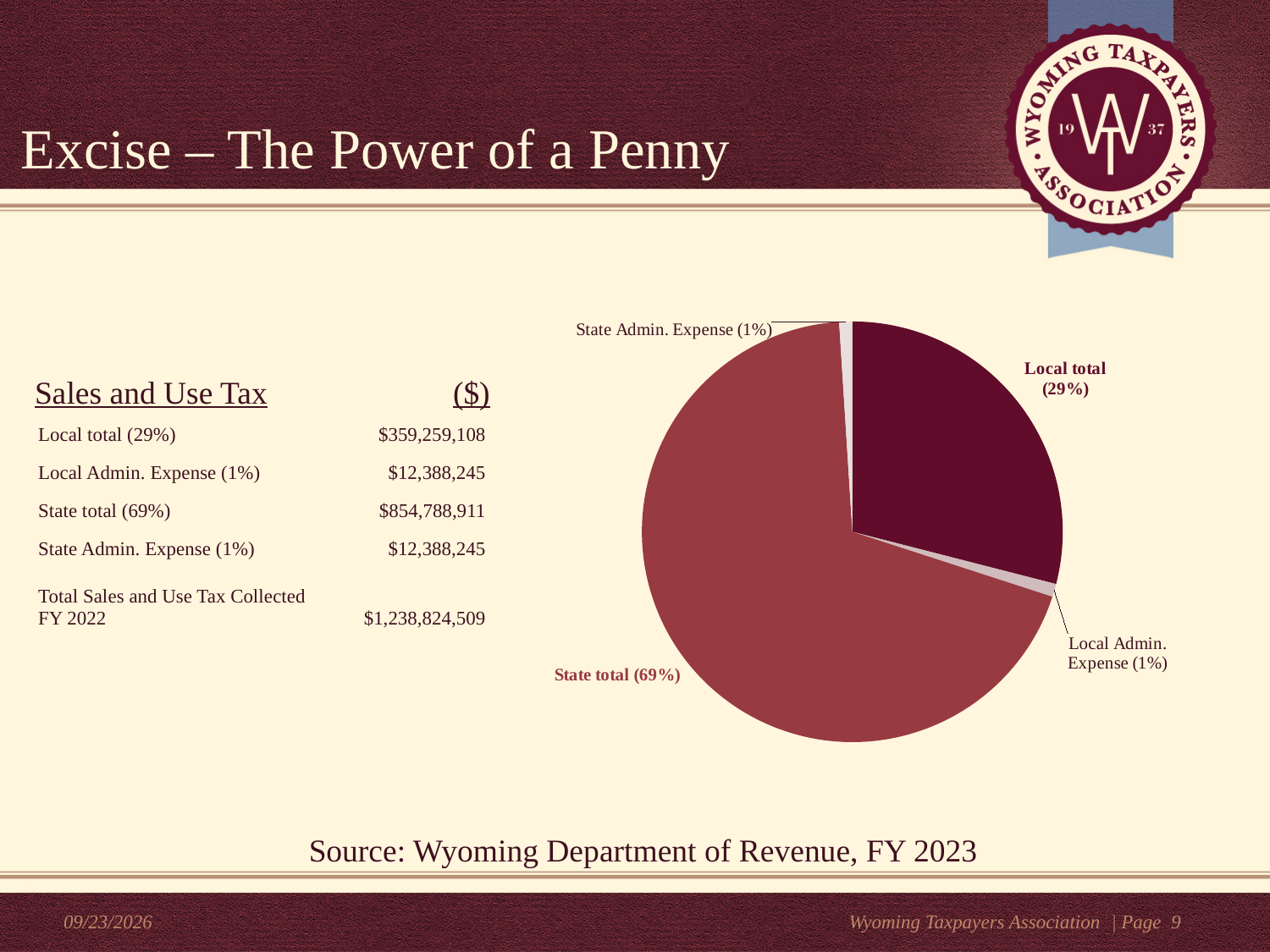
According to the table next to the pie chart, what is the dollar value for State total? $854,788,911 What is the Total Sales and Use Tax Collected for FY 2022 shown on the slide? $1,238,824,509 What share of the pie does Local total represent? 29% What share of the pie does State total represent? 69% According to the table next to the pie chart, what is the dollar value for Local total? $359,259,108 What kind of chart is shown on the slide? Pie chart What is the difference in percentage points between the State total share and the Local total share? 40 percentage points How many slices does the pie chart have? 4 What share of the pie does Local Admin. Expense represent? 1% Which is larger in the pie chart, Local total or State total? State total Which slice of the pie chart is the largest? State total